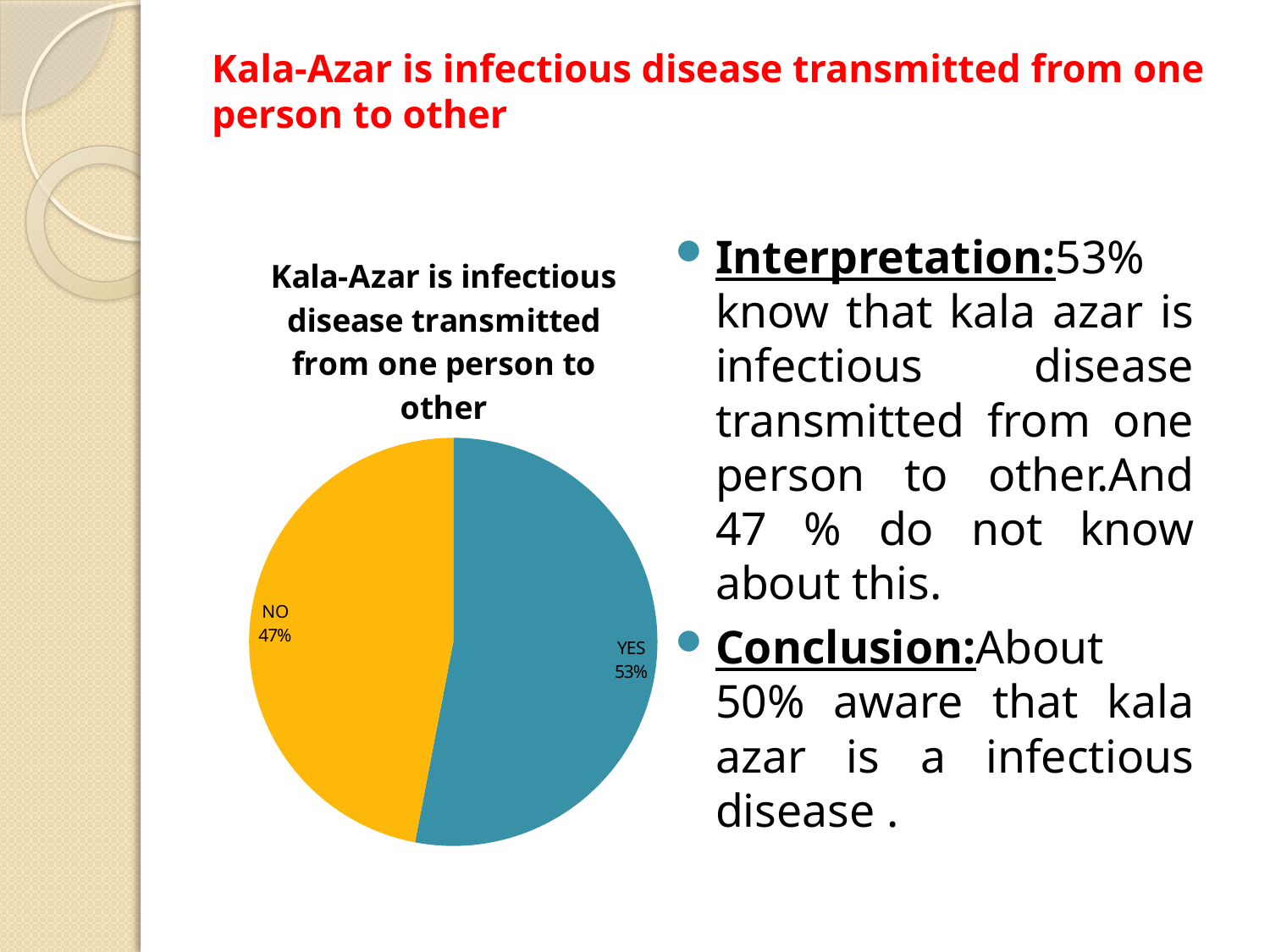
What percentage of respondents answered NO in the pie chart? 47% What is the difference in percentage points between the YES and NO slices? 6 Which slice of the pie chart is the smallest? NO What is the title of the pie chart? Kala-Azar is infectious disease transmitted from one person to other Which slice of the pie chart is the largest? YES What share of the pie does the NO slice represent? 47% What type of chart is shown on the slide? Pie chart What percentage of respondents answered YES in the pie chart? 53% How many slices does the pie chart have? 2 Which is larger in the pie chart, YES or NO? YES What colour is the YES slice of the pie chart? Blue